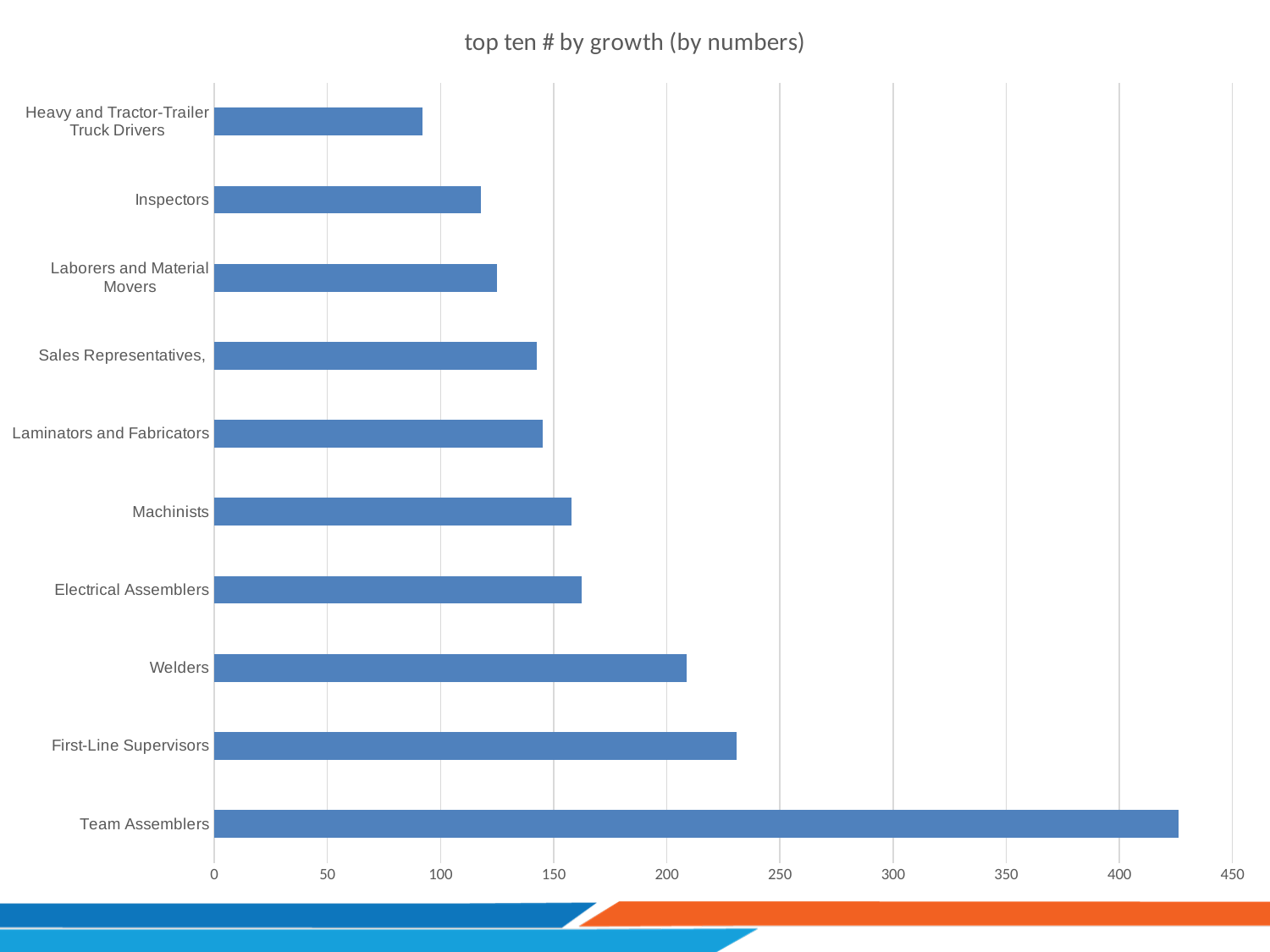
Which is larger, the value for Welders or the value for Machinists? Welders Which is larger, the value for First-Line Supervisors or the value for Electrical Assemblers? First-Line Supervisors Which category has the highest value? Team Assemblers Is the value for First-Line Supervisors greater or less than 250? less How many categories are plotted in the chart? 10 Is the value for Team Assemblers greater or less than 400? greater Is the value for Welders greater or less than 200? greater Which category has the lowest value? Heavy and Tractor-Trailer Truck Drivers What kind of chart is shown on the slide? bar chart What is the title of the chart? top ten # by growth (by numbers)